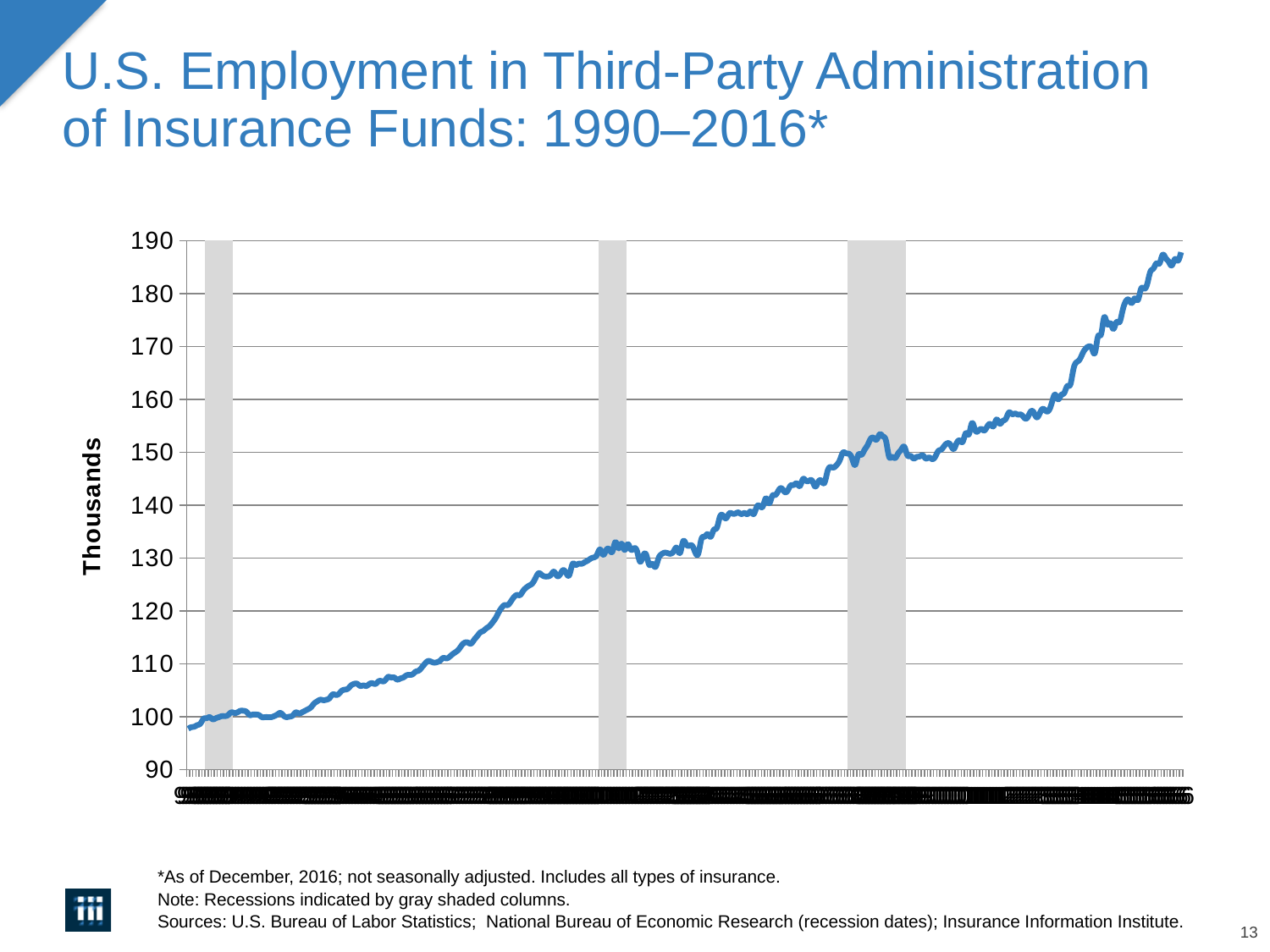
Is the value at the right-hand end of the line greater or less than 190? less Is the value of the line during the right-most gray shaded column greater or less than 140? greater What kind of chart is shown on the slide? line chart Is the value at the left-hand start of the line greater or less than 110? less Do the values generally rise or fall from left to right along the x axis? rise How many gray shaded recession columns appear on the chart? 3 What is the label on the vertical axis of the chart? Thousands Is the value at the right-hand end of the line larger or smaller than the value at the left-hand start? larger